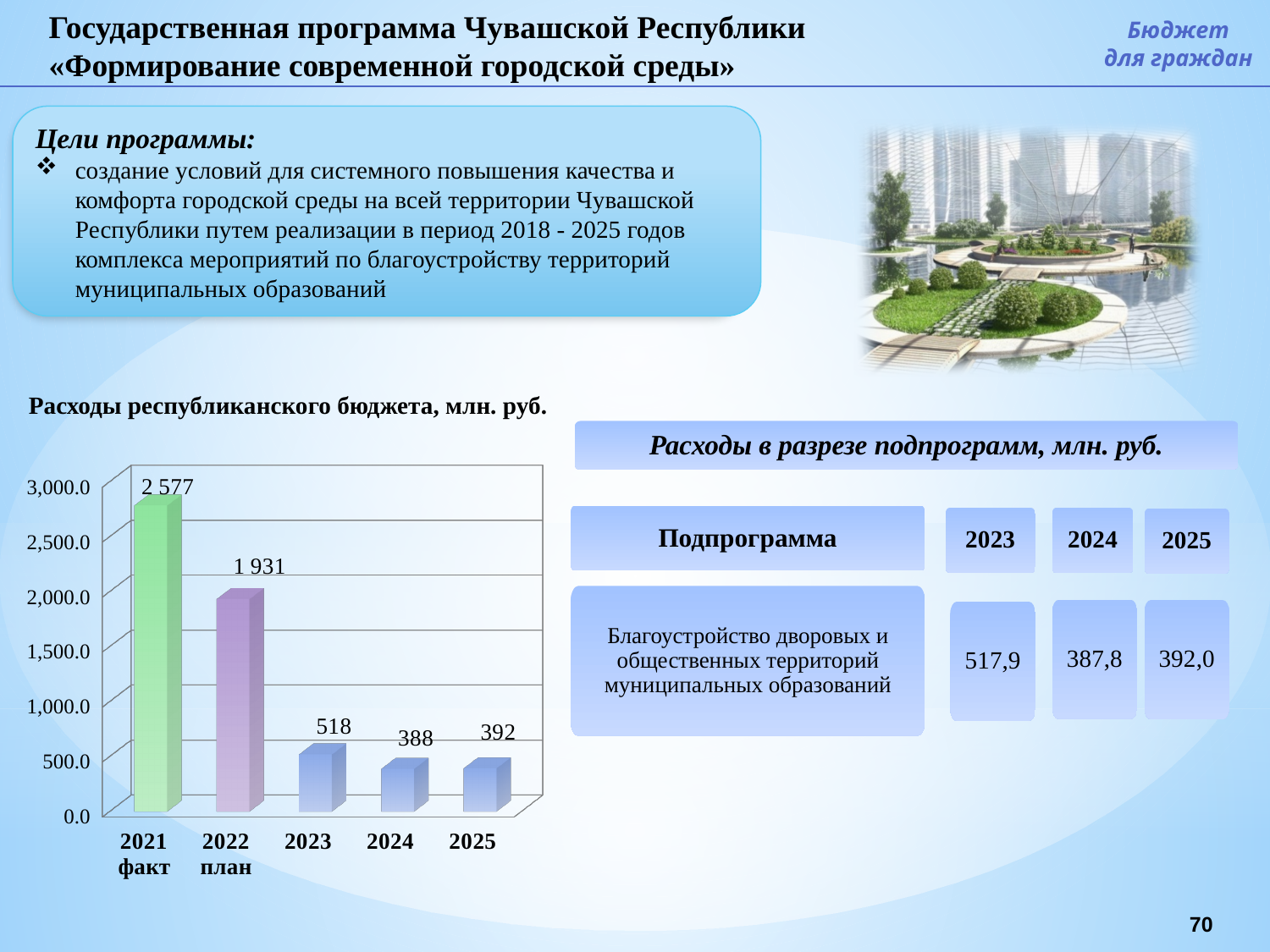
How many categories are shown on the x axis of the chart «Расходы республиканского бюджета, млн. руб.»? 5 Which category has the highest value in the chart «Расходы республиканского бюджета, млн. руб.»? 2021 факт What is the value for 2023 in the chart «Расходы республиканского бюджета, млн. руб.»? 518 What is the value for 2021 факт in the chart «Расходы республиканского бюджета, млн. руб.»? 2 577 Which category has the lowest value in the chart «Расходы республиканского бюджета, млн. руб.»? 2024 What is the value for 2022 план in the chart «Расходы республиканского бюджета, млн. руб.»? 1 931 What type of chart is shown under the heading «Расходы республиканского бюджета, млн. руб.»? bar chart In the chart «Расходы республиканского бюджета, млн. руб.», what is the difference between the values for 2021 факт and 2022 план? 646 In the chart «Расходы республиканского бюджета, млн. руб.», is the value for 2022 план greater or less than 2,000.0? less In the chart «Расходы республиканского бюджета, млн. руб.», which is larger: the value for 2022 план or the value for 2023? 2022 план In the chart «Расходы республиканского бюджета, млн. руб.», what is the difference between the values for 2023 and 2024? 130 What is the value for 2025 in the chart «Расходы республиканского бюджета, млн. руб.»? 392